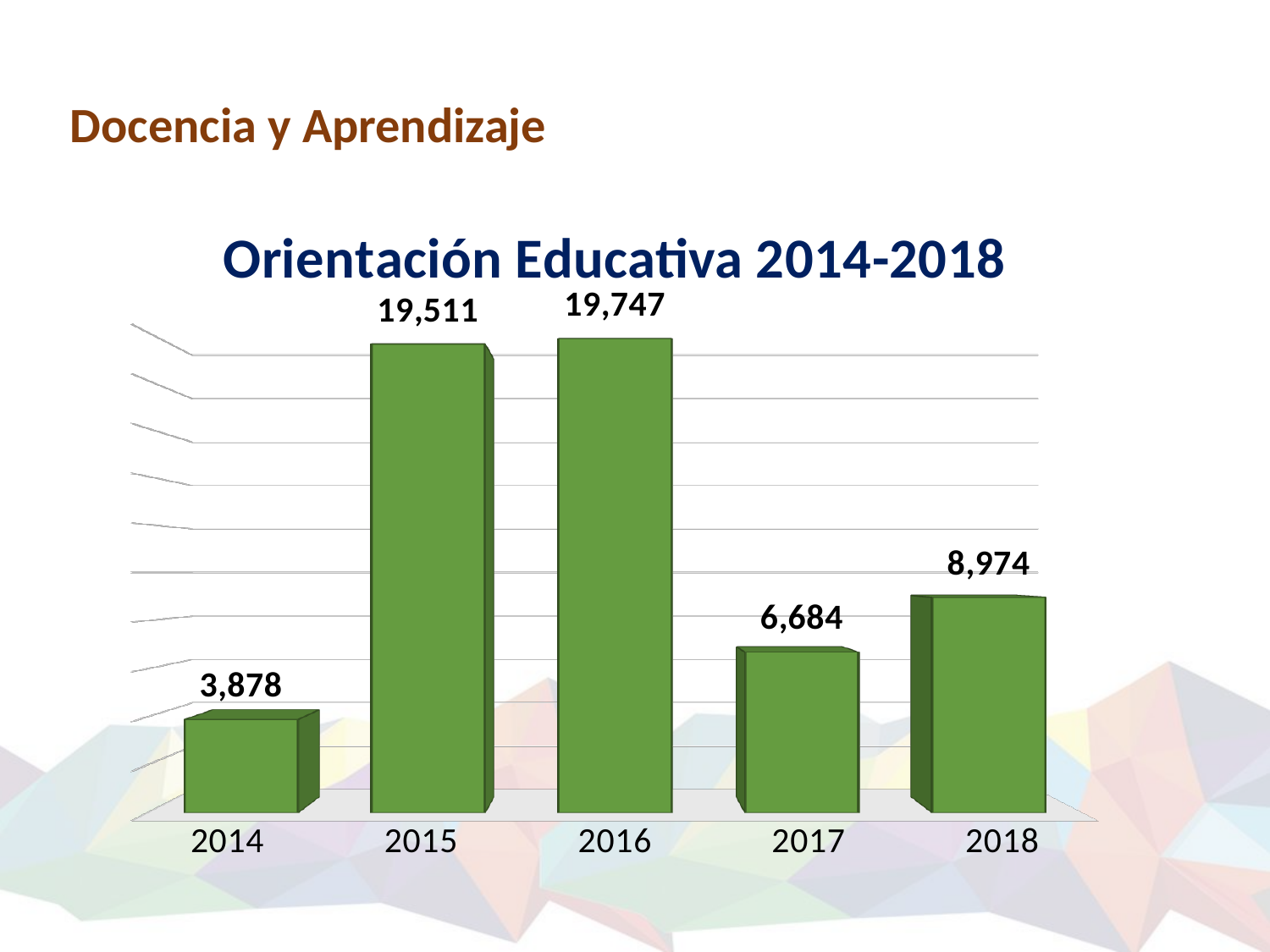
What is the title of the chart on the slide? Orientación Educativa 2014-2018 Which is larger in the Orientación Educativa 2014-2018 chart, the value for 2017 or the value for 2018? 2018 What is the value for 2014 in the Orientación Educativa 2014-2018 chart? 3,878 What is the value for 2016 in the Orientación Educativa 2014-2018 chart? 19,747 What is the difference between the values for 2018 and 2017 in the Orientación Educativa 2014-2018 chart? 2,290 Which year has the highest value in the Orientación Educativa 2014-2018 chart? 2016 What kind of chart is the Orientación Educativa 2014-2018 chart? Bar chart Do the values in the Orientación Educativa 2014-2018 chart rise or fall from 2016 to 2017? Fall What is the value for 2018 in the Orientación Educativa 2014-2018 chart? 8,974 What is the difference between the values for 2016 and 2015 in the Orientación Educativa 2014-2018 chart? 236 Which year has the lowest value in the Orientación Educativa 2014-2018 chart? 2014 How many years are shown on the x axis of the Orientación Educativa 2014-2018 chart? 5